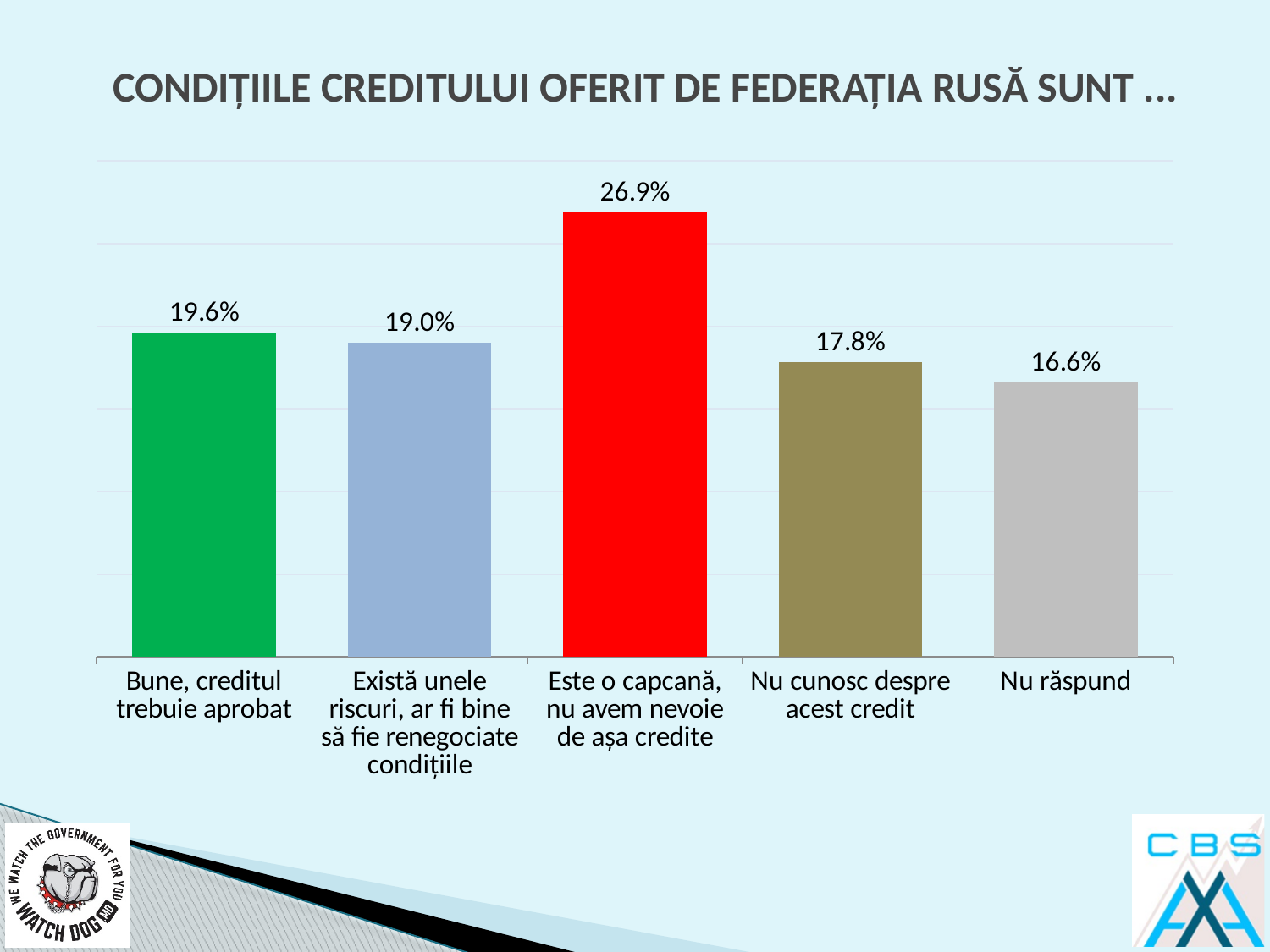
What is the value for "Nu răspund"? 16.6% What is the value for "Este o capcană, nu avem nevoie de așa credite"? 26.9% Which category has the highest value? Este o capcană, nu avem nevoie de așa credite What colour is the bar for "Este o capcană, nu avem nevoie de așa credite"? Red What is the value for "Bune, creditul trebuie aprobat"? 19.6% What is the value for "Nu cunosc despre acest credit"? 17.8% Which category has the lowest value? Nu răspund Which is larger: the value for "Nu cunosc despre acest credit" or the value for "Nu răspund"? Nu cunosc despre acest credit What is the difference between the values for "Este o capcană, nu avem nevoie de așa credite" and "Nu răspund"? 10.3% How many categories are shown in the chart? 5 What kind of chart is shown on the slide? Bar chart What is the difference between the values for "Bune, creditul trebuie aprobat" and "Există unele riscuri, ar fi bine să fie renegociate condițiile"? 0.6%